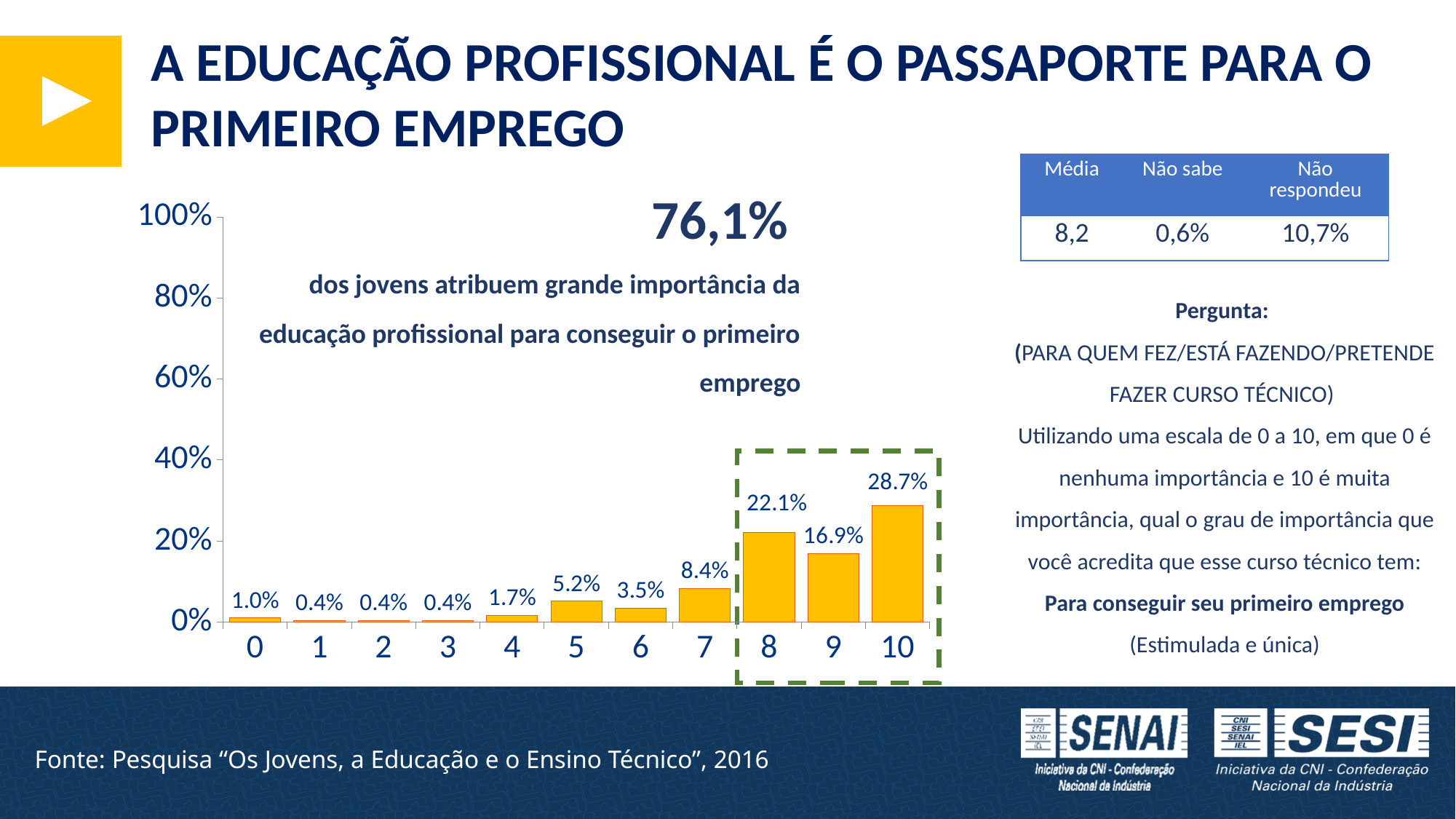
Is the value for category 8 greater or less than 20%? greater What is the value for category 8? 22.1% Which category has the highest value? 10 How many categories are shown on the x axis? 11 What is the value for category 5? 5.2% What kind of chart is shown on the slide? bar chart Which is larger, the value for category 7 or the value for category 6? 7 What is the difference between the values for categories 10 and 9? 11.8% What is the value for category 0? 1.0% What is the value for category 10? 28.7% What colour are the bars in the chart? yellow/orange What is the total of the values for categories 8, 9 and 10? 67.7%